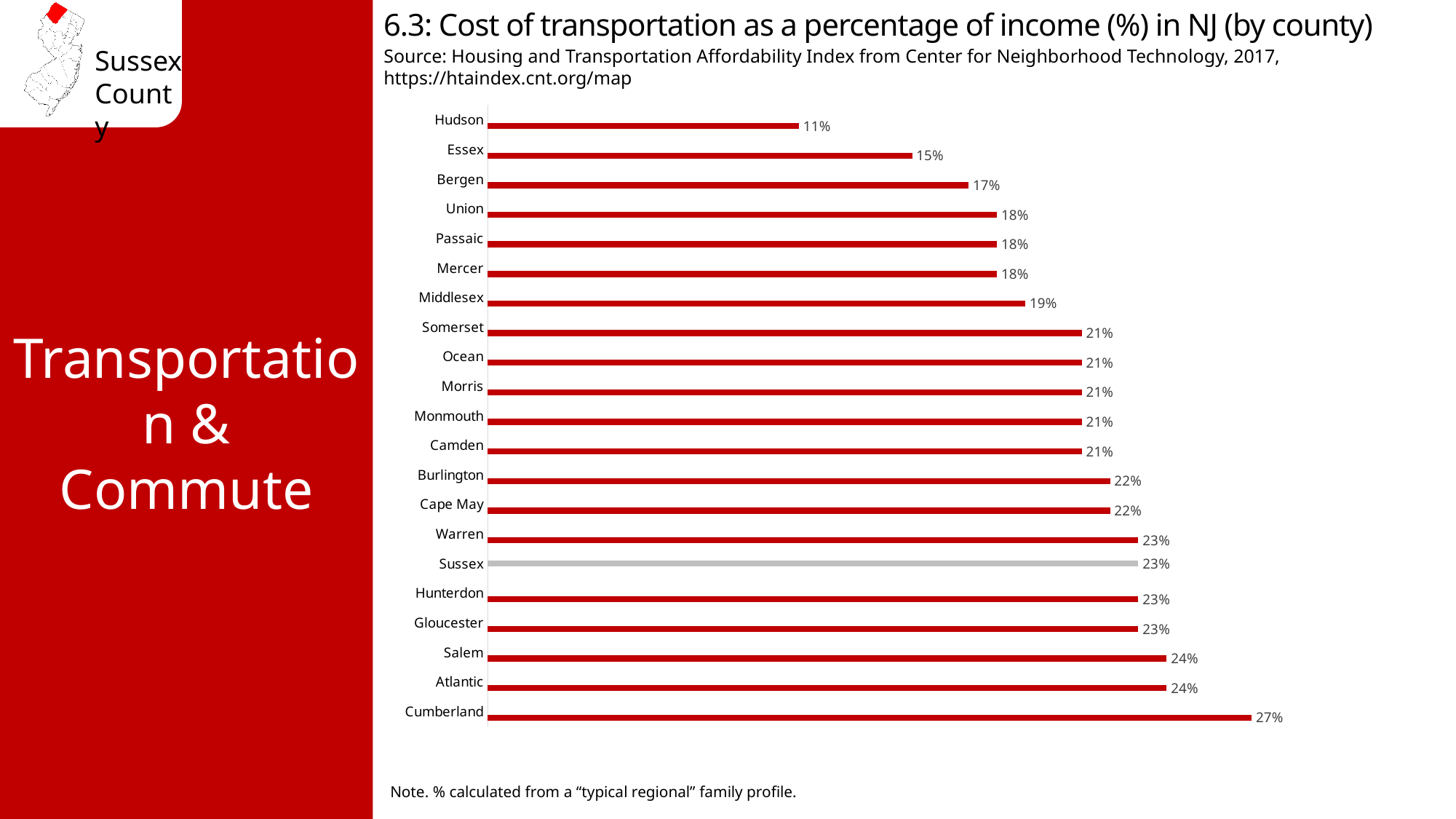
How many counties are shown in the chart? 21 What is the value shown for Atlantic County? 24% Which county's bar is shown in a different colour (grey) from the others? Sussex What is the difference between the values for Cumberland and Hudson? 16% What is the value shown for Middlesex County? 19% What is the cost of transportation as a percentage of income for Sussex County? 23% Which county has the lowest cost of transportation as a percentage of income? Hudson What type of chart is shown on the slide? Bar chart Which has a higher value, Bergen or Salem? Salem Which county has the highest cost of transportation as a percentage of income? Cumberland What is the value shown for Hudson County? 11% What is the difference between the values for Sussex and Essex? 8%